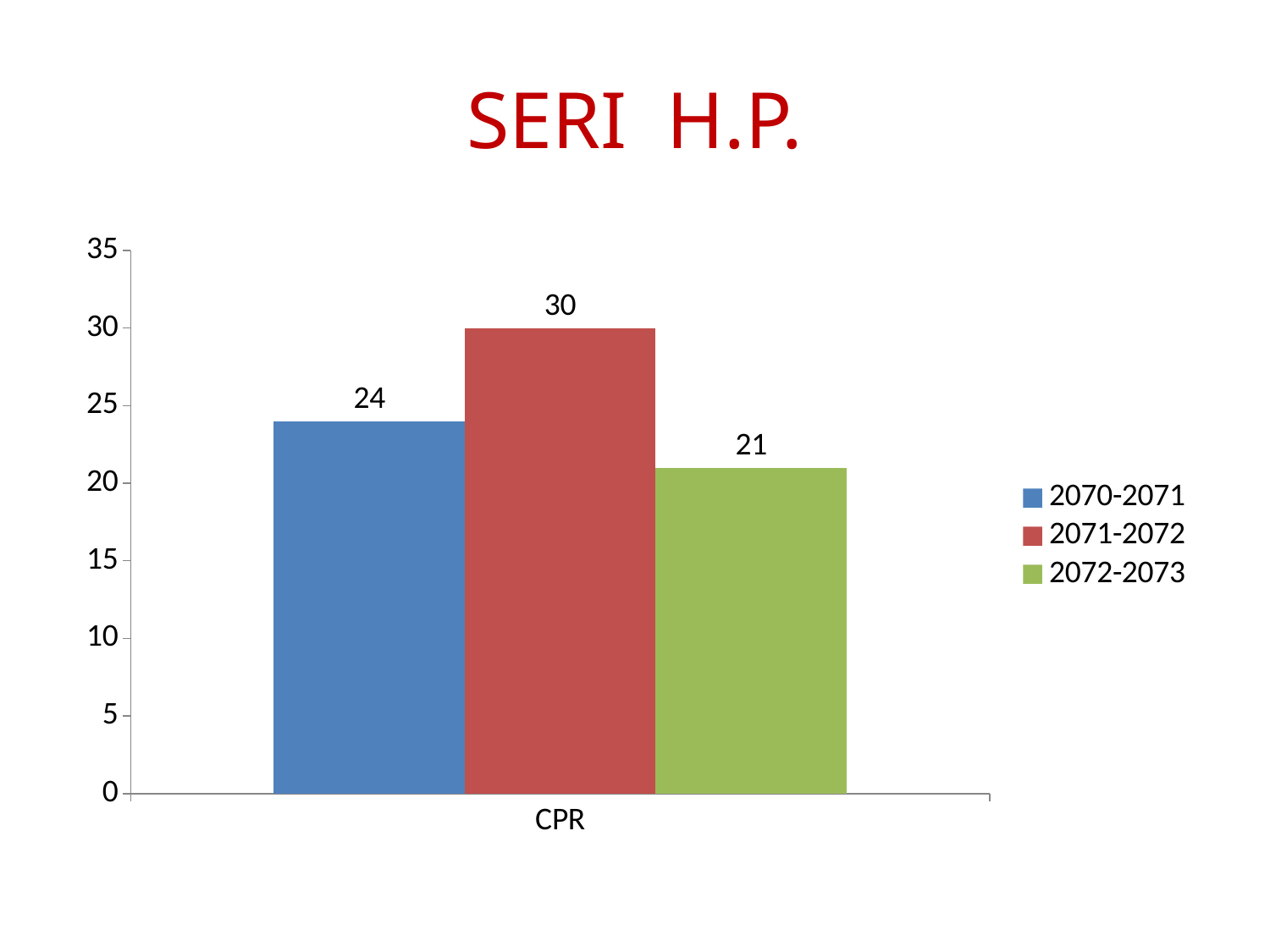
How many series does the legend list? 3 What is the CPR value for 2070-2071? 24 What is the CPR value for 2071-2072? 30 Is the CPR value for 2071-2072 greater or less than 25? greater What kind of chart is shown on the slide? Bar chart Which is larger, the CPR value for 2070-2071 or for 2072-2073? 2070-2071 What is the difference between the CPR values for 2071-2072 and 2072-2073? 9 What is the difference between the CPR values for 2070-2071 and 2072-2073? 3 What is the CPR value for 2072-2073? 21 Which series has the lowest CPR value? 2072-2073 What is the title of the slide? SERI H.P. Which series has the highest CPR value? 2071-2072